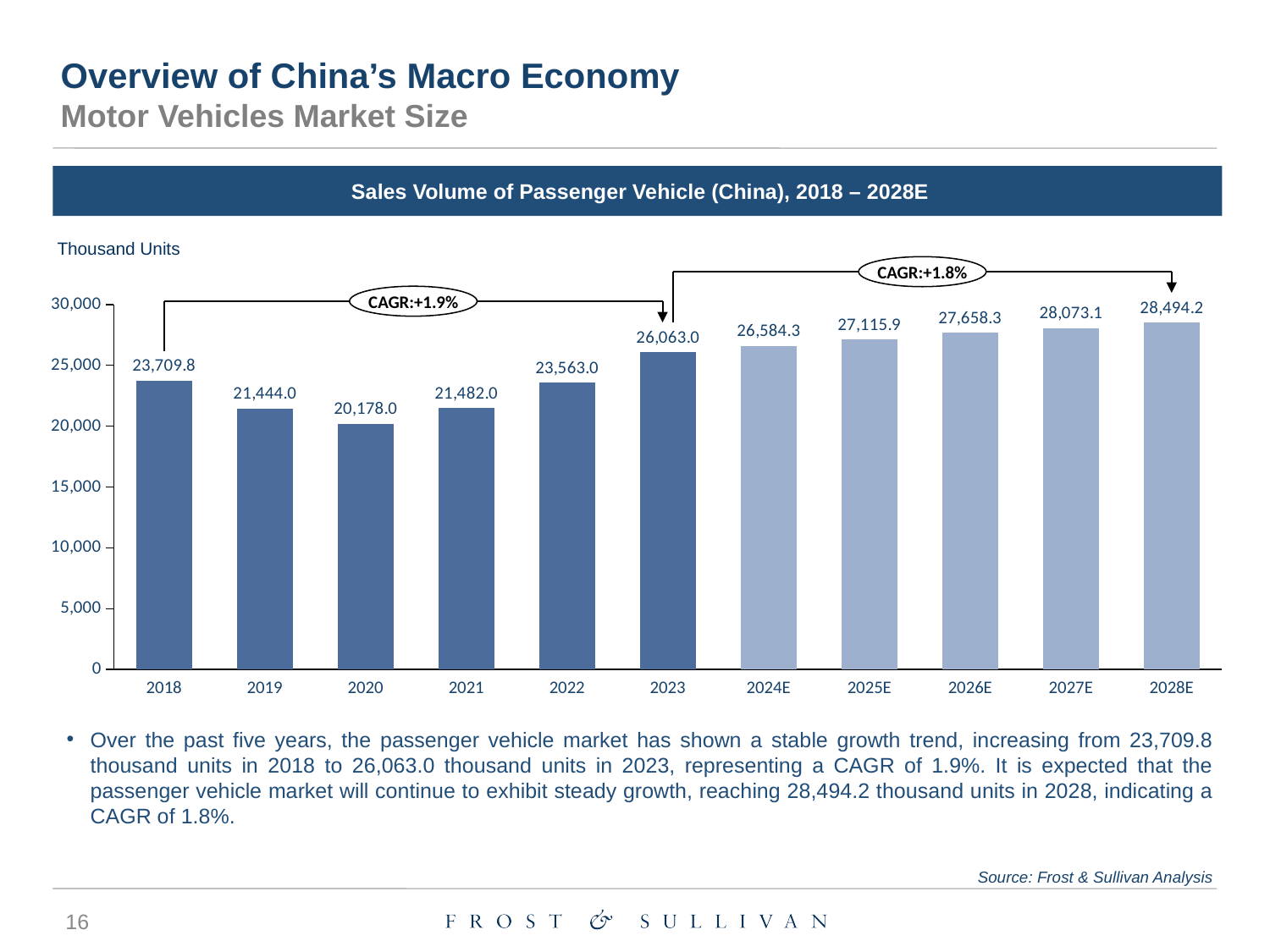
What type of chart is used to show the sales volume of passenger vehicles? Bar chart Which year has the lowest sales volume of passenger vehicles in the chart? 2020 What is the sales volume of passenger vehicles in China in 2023? 26,063.0 What is the sales volume of passenger vehicles in China in 2020? 20,178.0 Do the sales volumes rise or fall from 2023 to 2028E? Rise What is the projected sales volume of passenger vehicles in China for 2028E? 28,494.2 What is the difference in sales volume between 2023 and 2018? 2,353.2 What unit is used for the values in the chart? Thousand Units What is the CAGR shown for the period 2018 to 2023? +1.9% Which year has a larger sales volume, 2019 or 2022? 2022 Which year has the highest sales volume of passenger vehicles in the chart? 2028E How many years are shown on the x axis of the chart? 11